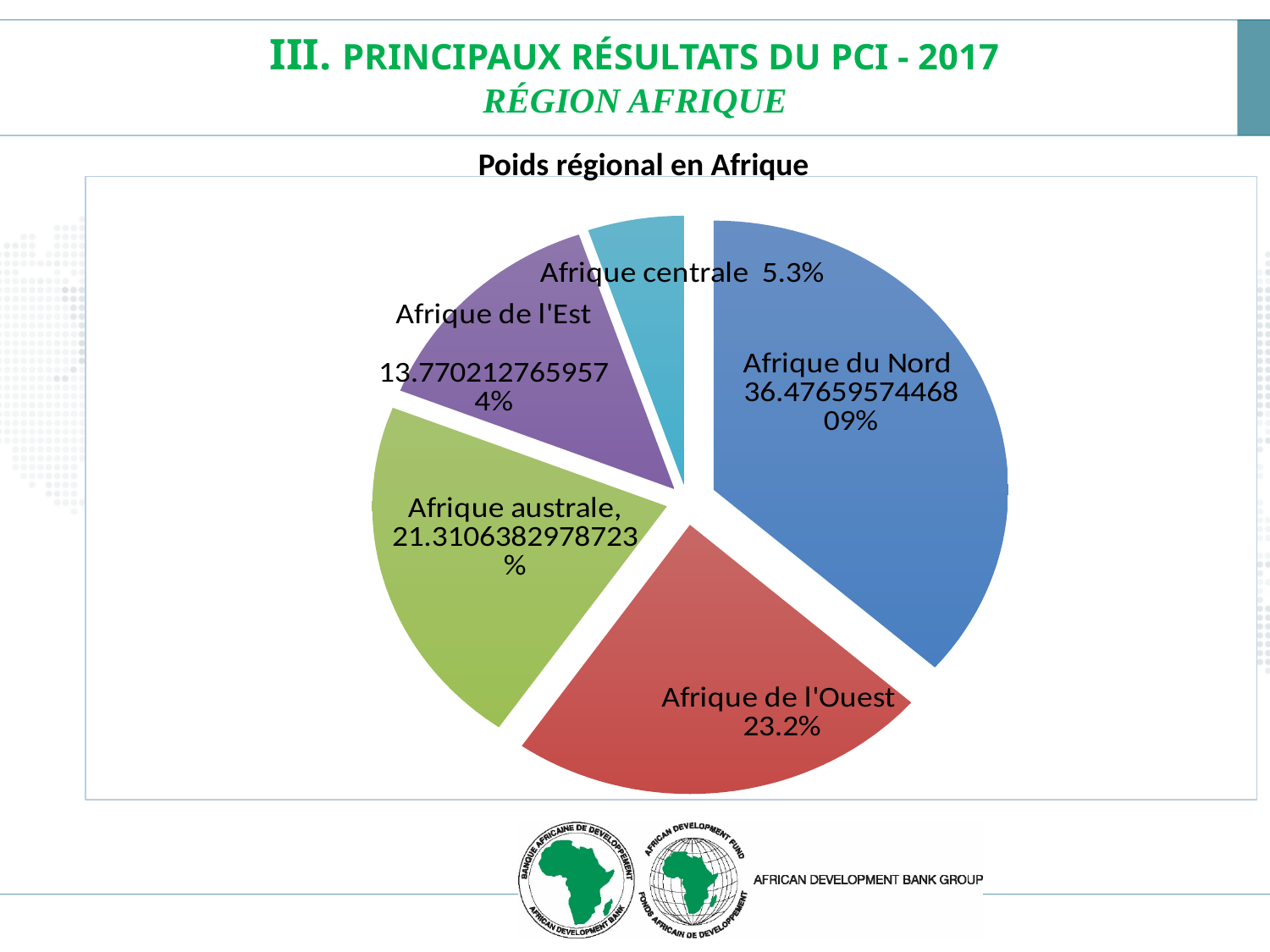
What is the value shown for Afrique australe? 21.3106382978723% What type of chart is shown on the slide? Pie chart What is the value shown for Afrique du Nord in the pie chart? 36.4765957446809% What is the title of the chart? Poids régional en Afrique What is the difference between the values for Afrique de l'Ouest and Afrique centrale? 17.9% Which is larger, the slice for Afrique de l'Ouest or the slice for Afrique de l'Est? Afrique de l'Ouest What share of the pie does Afrique centrale represent? 5.3% What is the value shown for Afrique de l'Est? 13.7702127659574% How many regions (slices) are shown in the pie chart? 5 Which region has the smallest slice of the pie? Afrique centrale Which region has the largest slice of the pie? Afrique du Nord What is the value shown for Afrique de l'Ouest? 23.2%